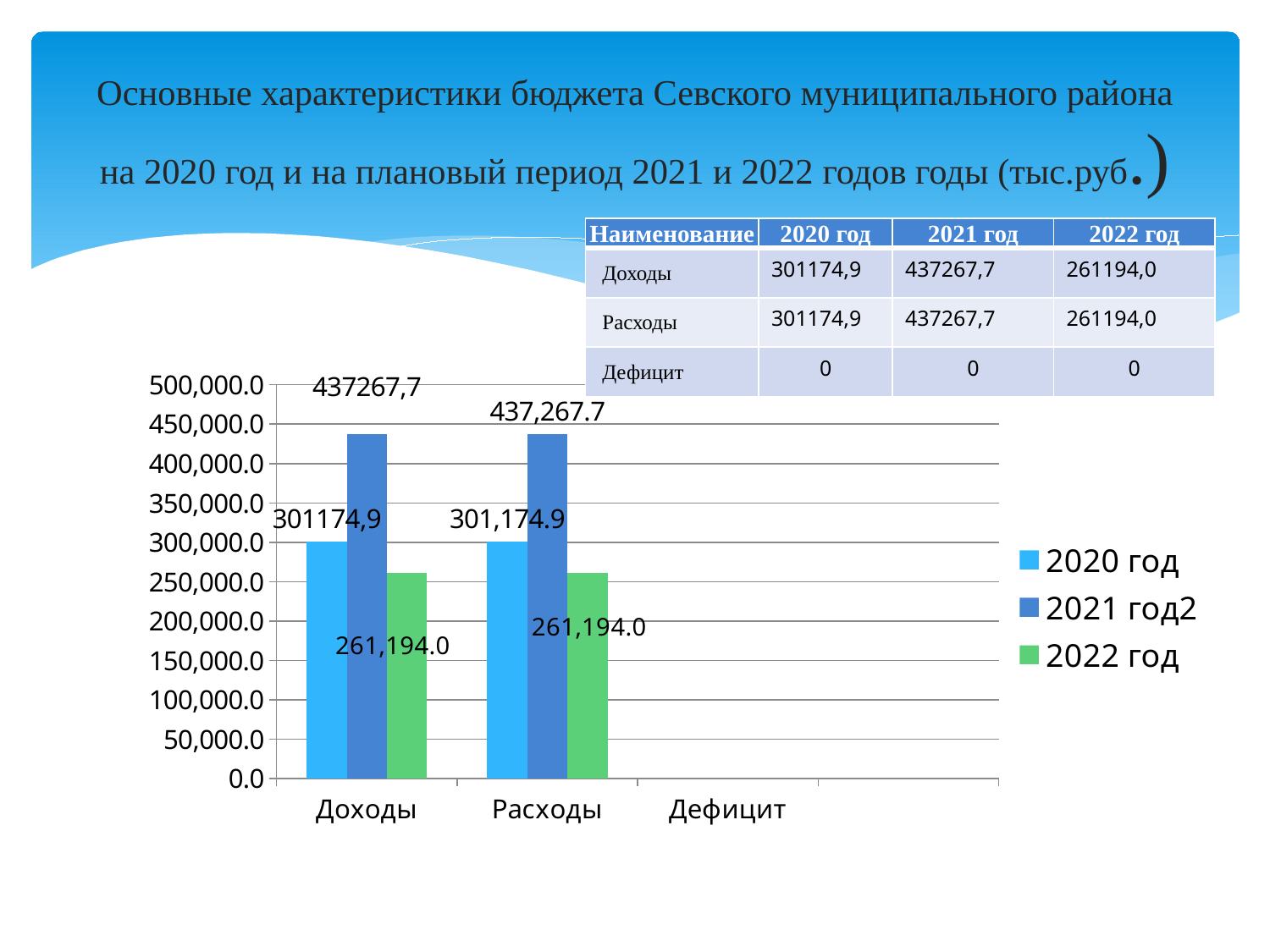
What is the value of the 2020 год series for Расходы? 301,174.9 What colour are the bars for the 2022 год series? green What is the difference between the 2021 год2 and 2020 год values for Расходы? 136,092.8 What is the value of the 2021 год2 series for Доходы? 437267,7 How many categories are shown on the x axis of the chart? 3 Which is larger for Расходы: the 2020 год value or the 2022 год value? 2020 год Which series has the lowest value for Расходы? 2022 год What kind of chart is shown on the slide? bar chart Is the 2022 год value for Доходы greater or less than 300,000.0? less What is the value of the 2022 год series for Расходы? 261,194.0 Which series has the highest value for Доходы? 2021 год2 How many series does the chart legend list? 3